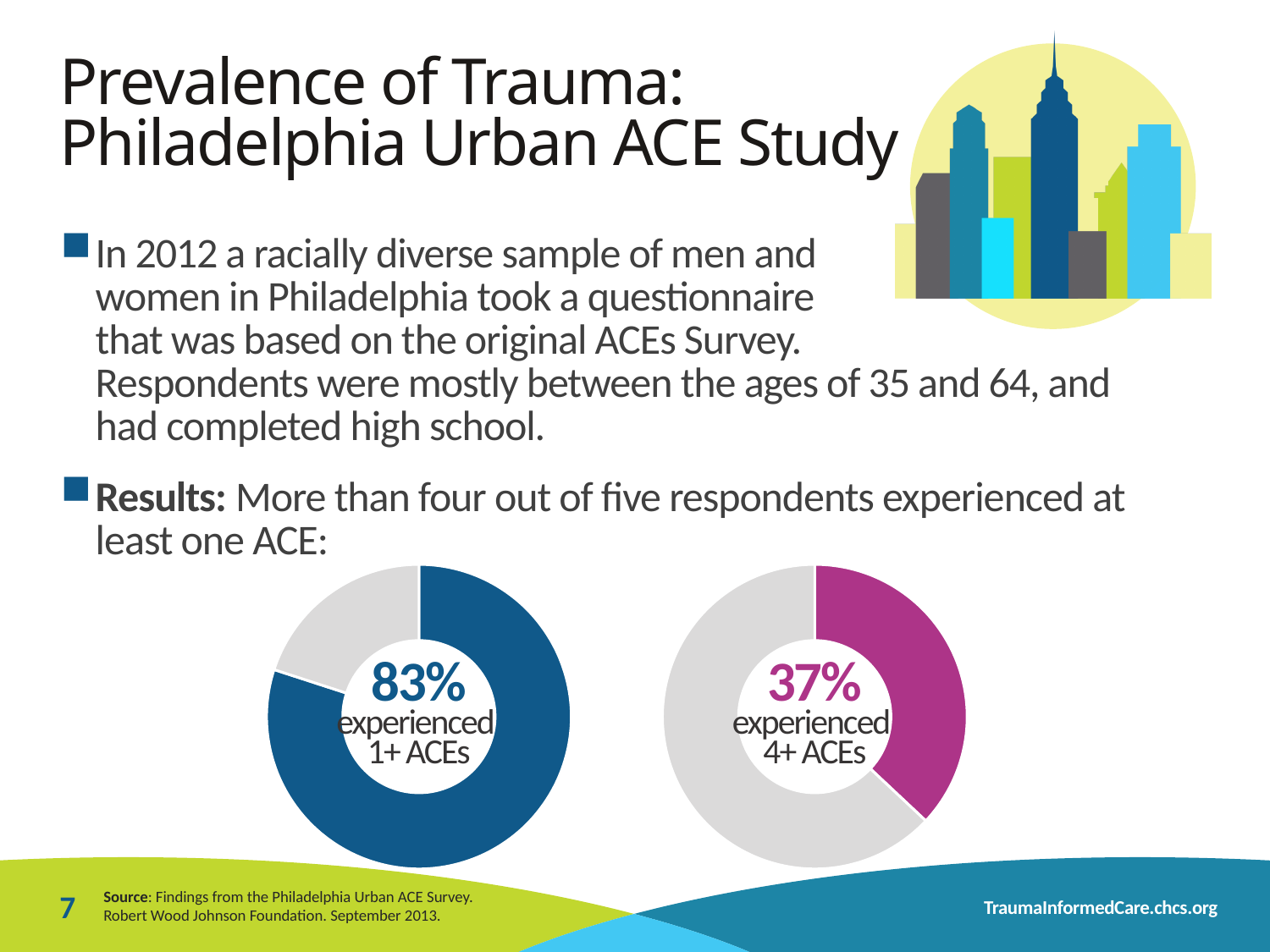
In the right donut chart, what share of the ring is taken up by the coloured (magenta) segment? 37% What colour is the segment representing respondents who experienced 4+ ACEs in the right donut chart? Magenta How many donut charts are shown on the slide? 2 Which is larger: the share of respondents who experienced 1+ ACEs or the share who experienced 4+ ACEs? 1+ ACEs What colour is the segment representing respondents who experienced 1+ ACEs in the left donut chart? Blue Which chart shows the smaller coloured segment, the left one (1+ ACEs) or the right one (4+ ACEs)? The right one (4+ ACEs) In the left donut chart, what percentage of respondents experienced 1+ ACEs? 83% In the right donut chart, what percentage of respondents experienced 4+ ACEs? 37% By how many percentage points does the share experiencing 1+ ACEs exceed the share experiencing 4+ ACEs? 46 percentage points What kind of chart is used to show the share of respondents who experienced 1+ ACEs? Donut (pie) chart